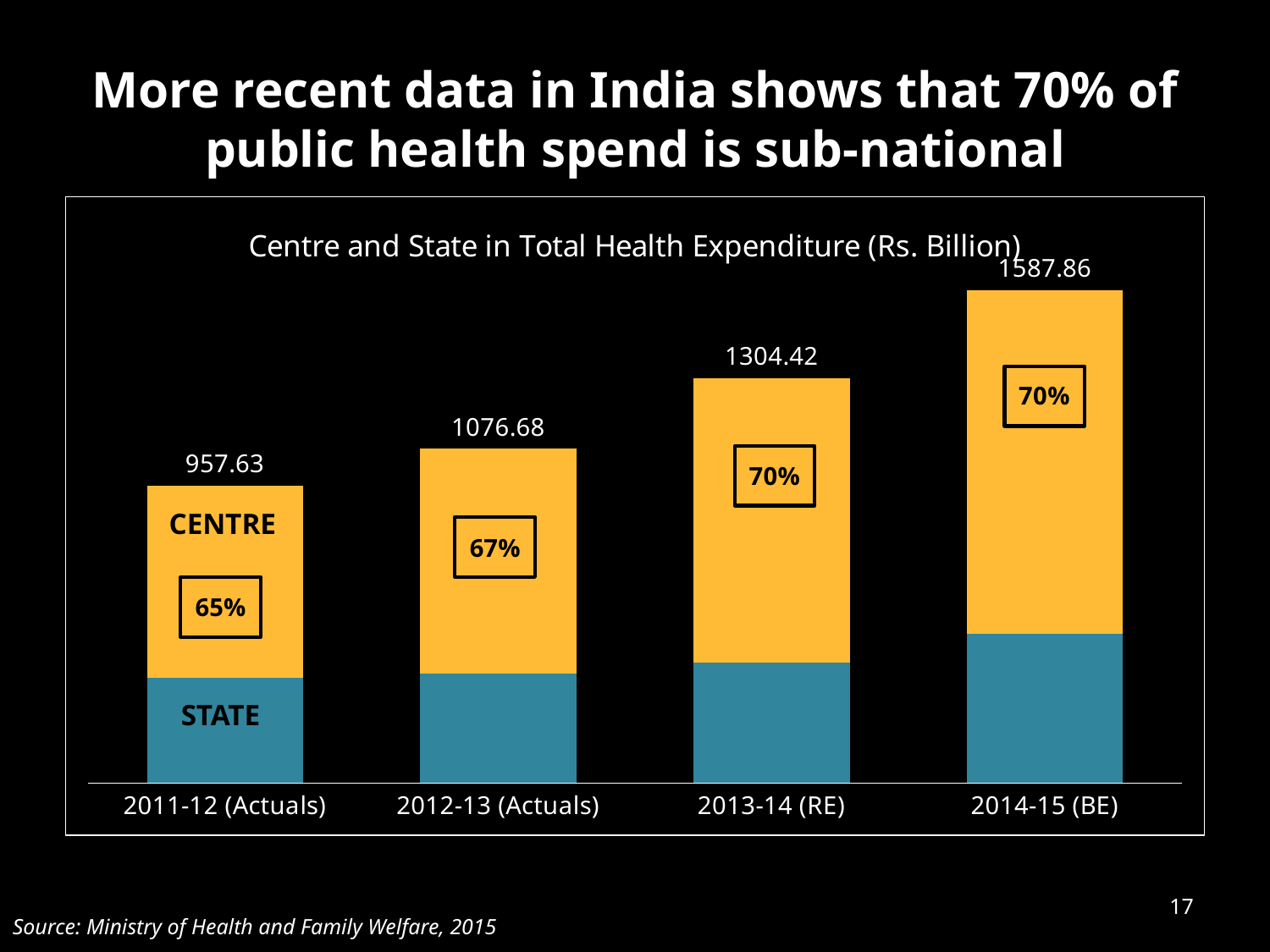
Which year has the highest total health expenditure? 2014-15 (BE) Which is larger, the total for 2012-13 (Actuals) or the total for 2013-14 (RE)? 2013-14 (RE) What is the total health expenditure shown for 2011-12 (Actuals)? 957.63 What percentage label is shown on the 2012-13 (Actuals) bar? 67% What percentage label is shown on the 2011-12 (Actuals) bar? 65% Which year has the lowest total health expenditure? 2011-12 (Actuals) What is the difference in total health expenditure between 2014-15 (BE) and 2011-12 (Actuals)? 630.23 How many years are shown on the x axis of the chart? 4 Do the total health expenditure values rise or fall from 2011-12 to 2014-15? Rise What is the total health expenditure shown for 2013-14 (RE)? 1304.42 What is the total health expenditure shown for 2014-15 (BE)? 1587.86 What kind of chart is shown on the slide? Stacked bar chart